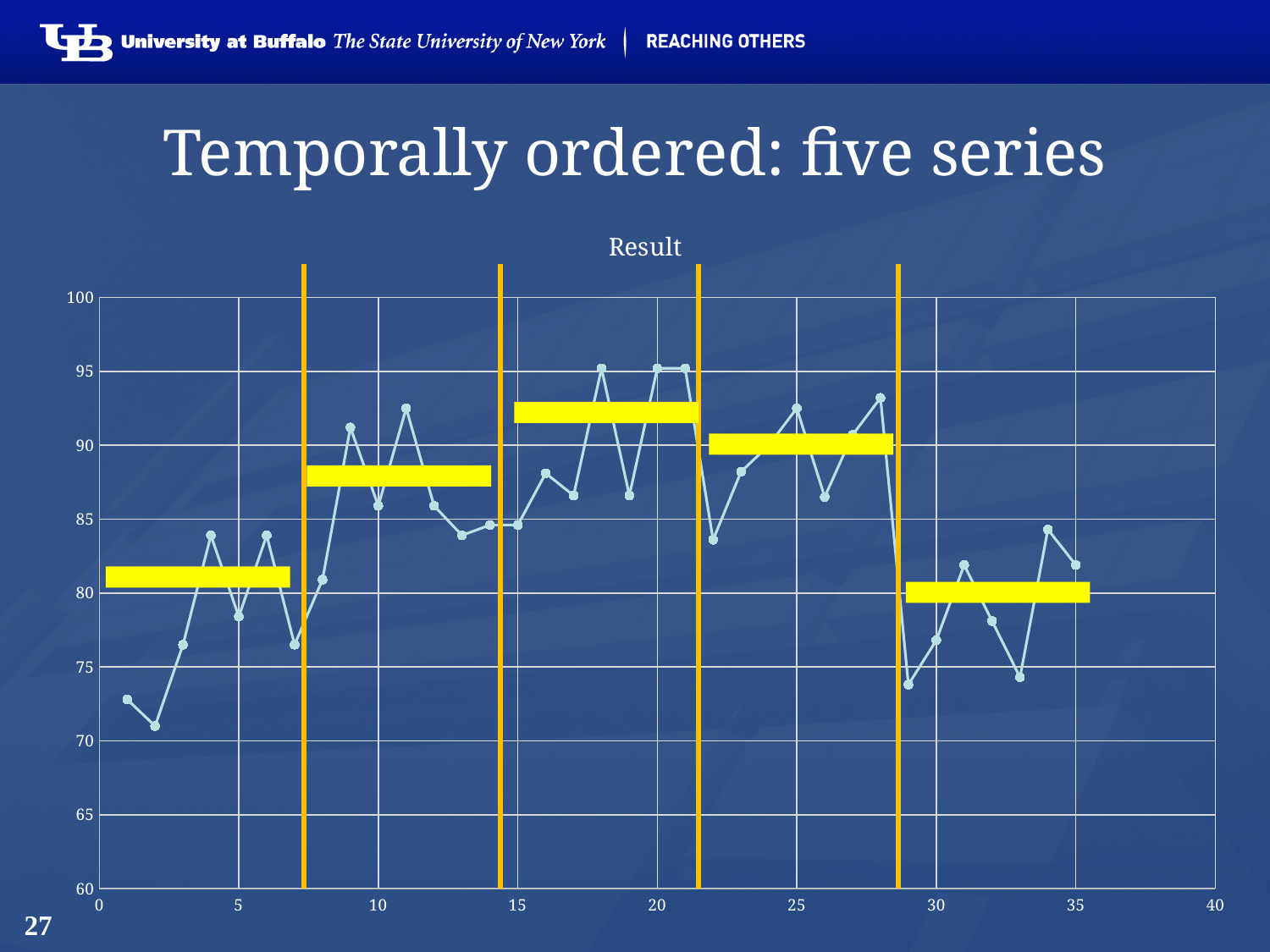
Which is larger, the value at x = 4 or the value at x = 9? x = 9 What kind of chart is shown on the slide? line chart Is the value at x = 29 greater or less than 80? less How many yellow horizontal bars are drawn on the chart? 5 Do the values rise or fall from x = 28 to x = 29? fall How many data points are plotted on the line? 35 Is the value at x = 2 greater or less than 75? less What is the title of the chart? Result What is the maximum value shown on the y axis? 100 Is the value at x = 11 greater or less than 90? greater At which x value does the line reach its lowest point? 2